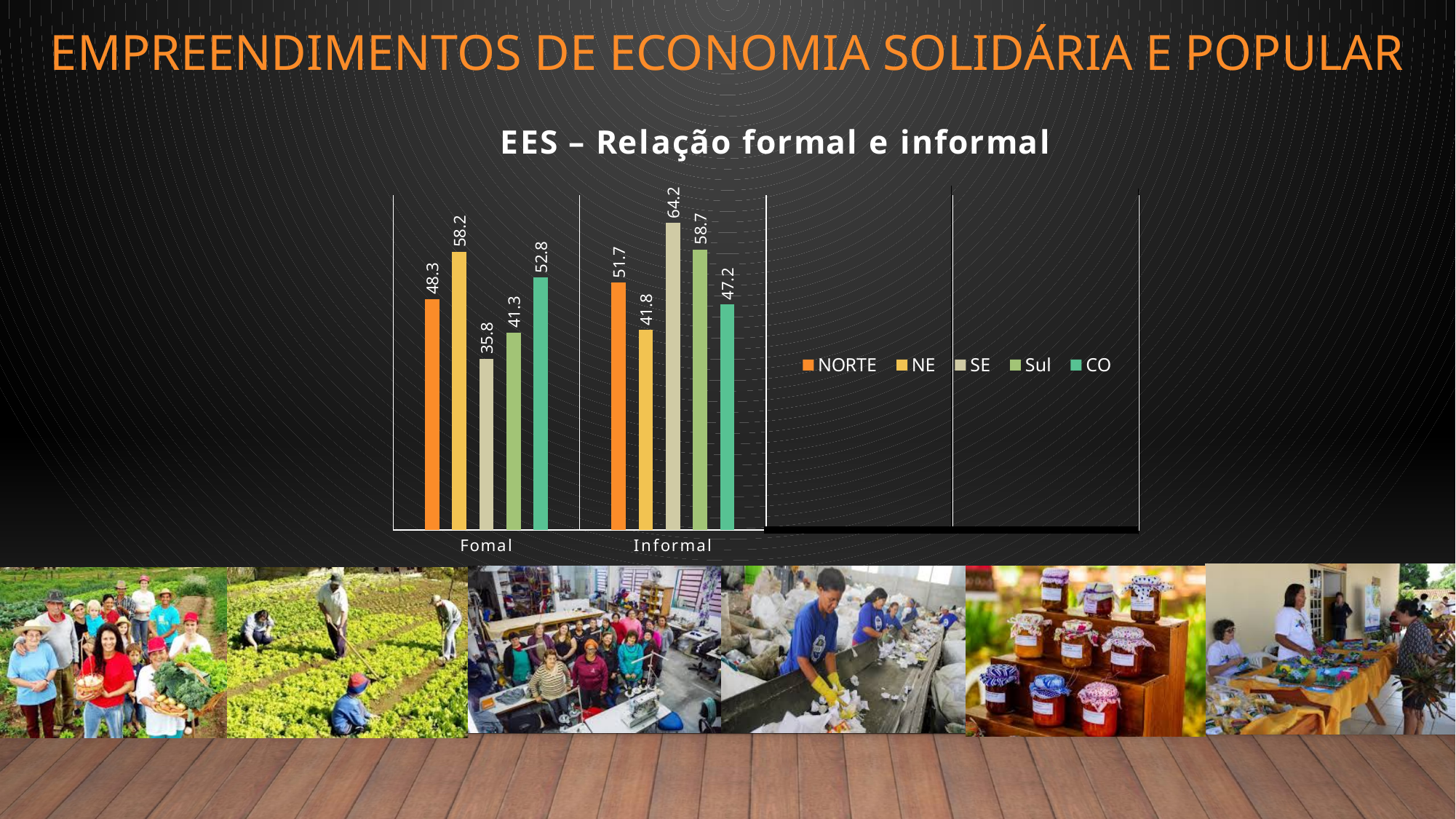
Which is larger: the CO value for Fomal or the CO value for Informal? Fomal What is the value for SE in the Informal category? 64.2 What is the value for NE in the Fomal category? 58.2 Which series has the highest value in the Informal category? SE Which series has the lowest value in the Informal category? NE What is the difference between the SE values for Informal and Fomal? 28.4 How many series does the legend list? 5 What kind of chart is shown on the slide? Bar chart How many categories are shown on the x axis? 2 Which series has the lowest value in the Fomal category? SE What is the title of the chart? EES – Relação formal e informal What is the value for NORTE in the Informal category? 51.7